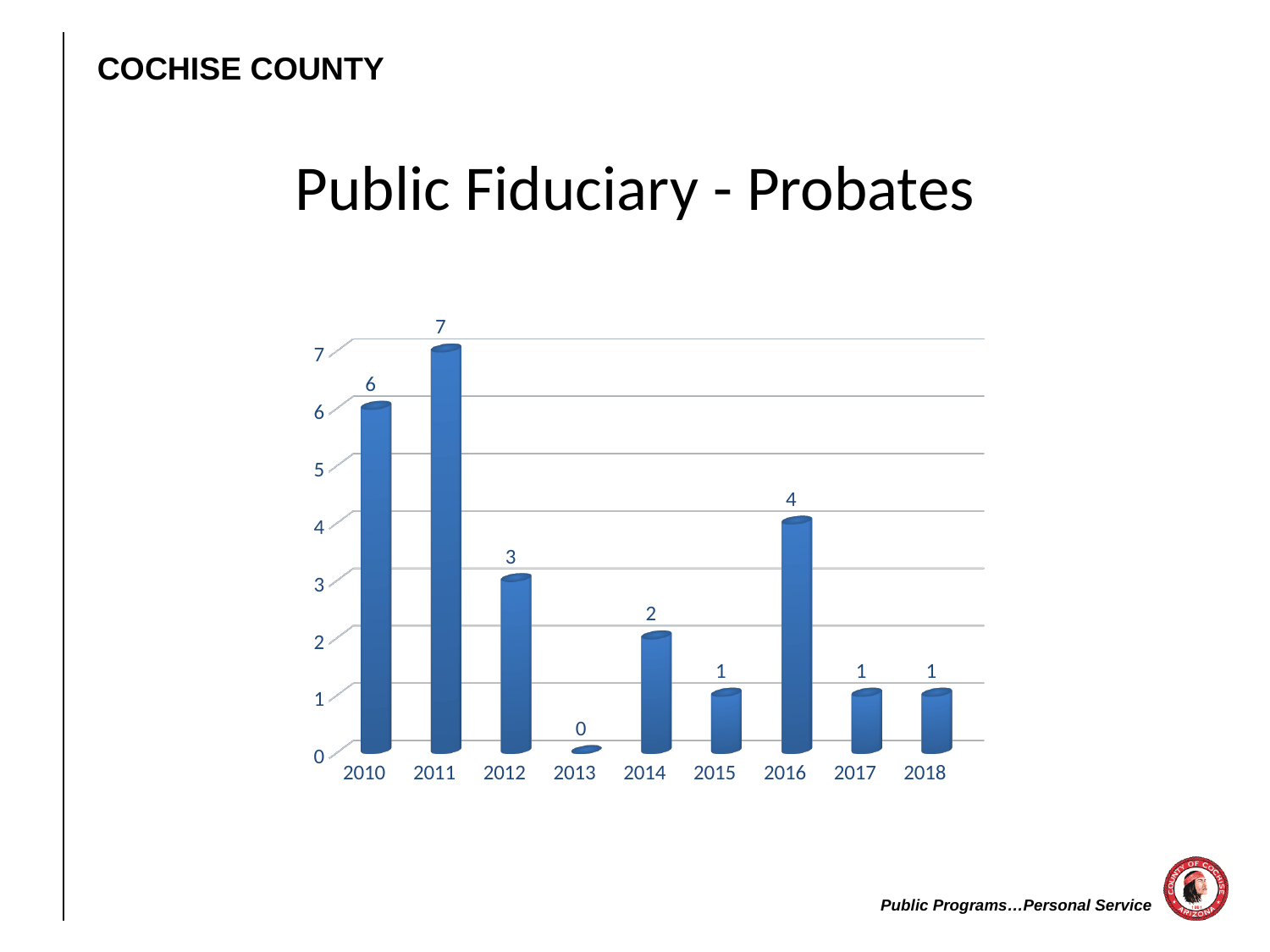
What is the title of the chart? Public Fiduciary - Probates What is the difference between the values for 2011 and 2016? 3 What is the difference between the values for 2010 and 2012? 3 What kind of chart is shown on the slide? bar chart How many years are shown on the x axis? 9 Which year has the highest value? 2011 What is the value for 2013? 0 Is the value for 2010 greater or less than 5? greater What is the value for 2016? 4 What is the value for 2011? 7 Which is larger, the value for 2014 or the value for 2016? 2016 Which year has the lowest value? 2013